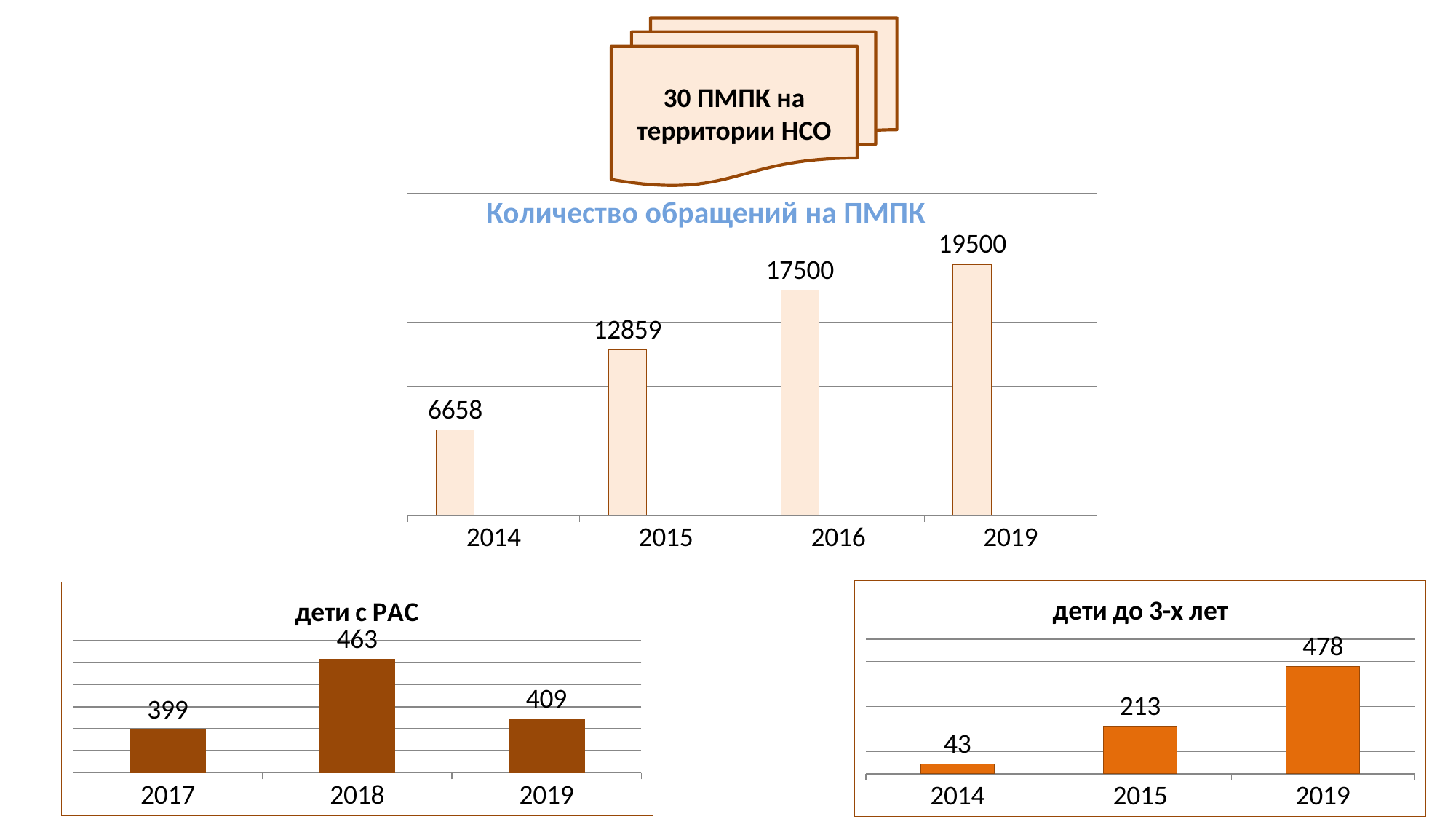
In the chart 'Количество обращений на ПМПК', what is the value for 2015? 12859 How many bars are in the chart 'Количество обращений на ПМПК'? 4 In the chart 'дети до 3-х лет', which is larger, the value for 2015 or the value for 2019? 2019 In the chart 'дети с РАС', what is the value for 2019? 409 In the chart 'дети с РАС', what is the difference between the values for 2018 and 2017? 64 In the chart 'Количество обращений на ПМПК', which year has the lowest value? 2014 How many charts are shown on the slide? 3 In the chart 'дети до 3-х лет', what is the value for 2014? 43 In the chart 'Количество обращений на ПМПК', what is the difference between the values for 2019 and 2016? 2000 What kind of chart is 'дети до 3-х лет'? bar chart In the chart 'Количество обращений на ПМПК', do the values rise or fall from 2014 to 2019? rise In the chart 'дети с РАС', which year has the highest value? 2018